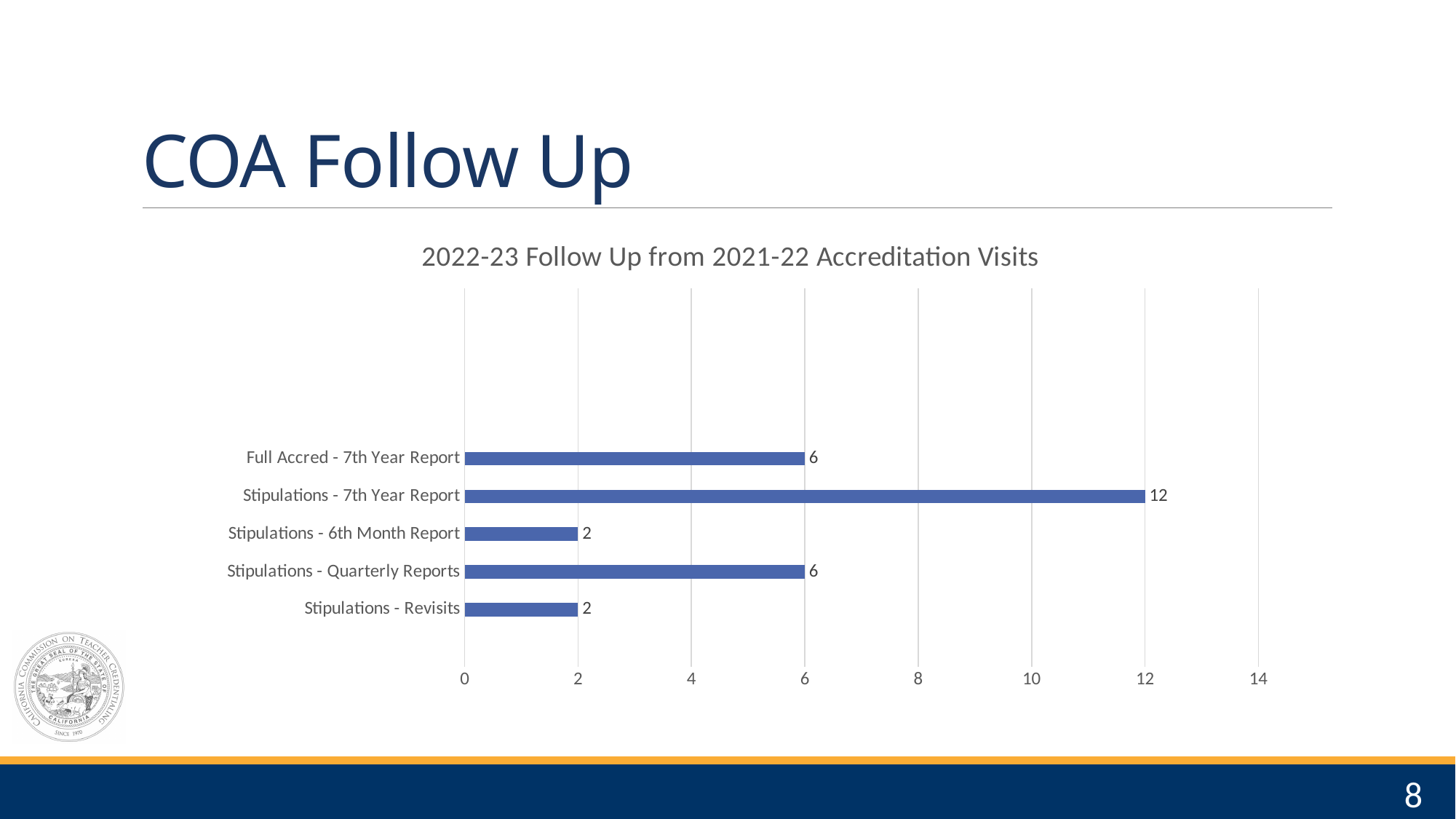
What is the value for Stipulations - 7th Year Report? 12 How many categories are shown in the chart? 5 Is the value for Stipulations - 7th Year Report greater or less than 10? greater Which is larger, Stipulations - Quarterly Reports or Stipulations - Revisits? Stipulations - Quarterly Reports What is the value for Stipulations - Quarterly Reports? 6 What is the value for Stipulations - 6th Month Report? 2 Which category has the highest value? Stipulations - 7th Year Report What is the title of the chart? 2022-23 Follow Up from 2021-22 Accreditation Visits What kind of chart is shown on the slide? bar chart What is the difference between Stipulations - 7th Year Report and Full Accred - 7th Year Report? 6 What is the value for Full Accred - 7th Year Report? 6 What is the value for Stipulations - Revisits? 2